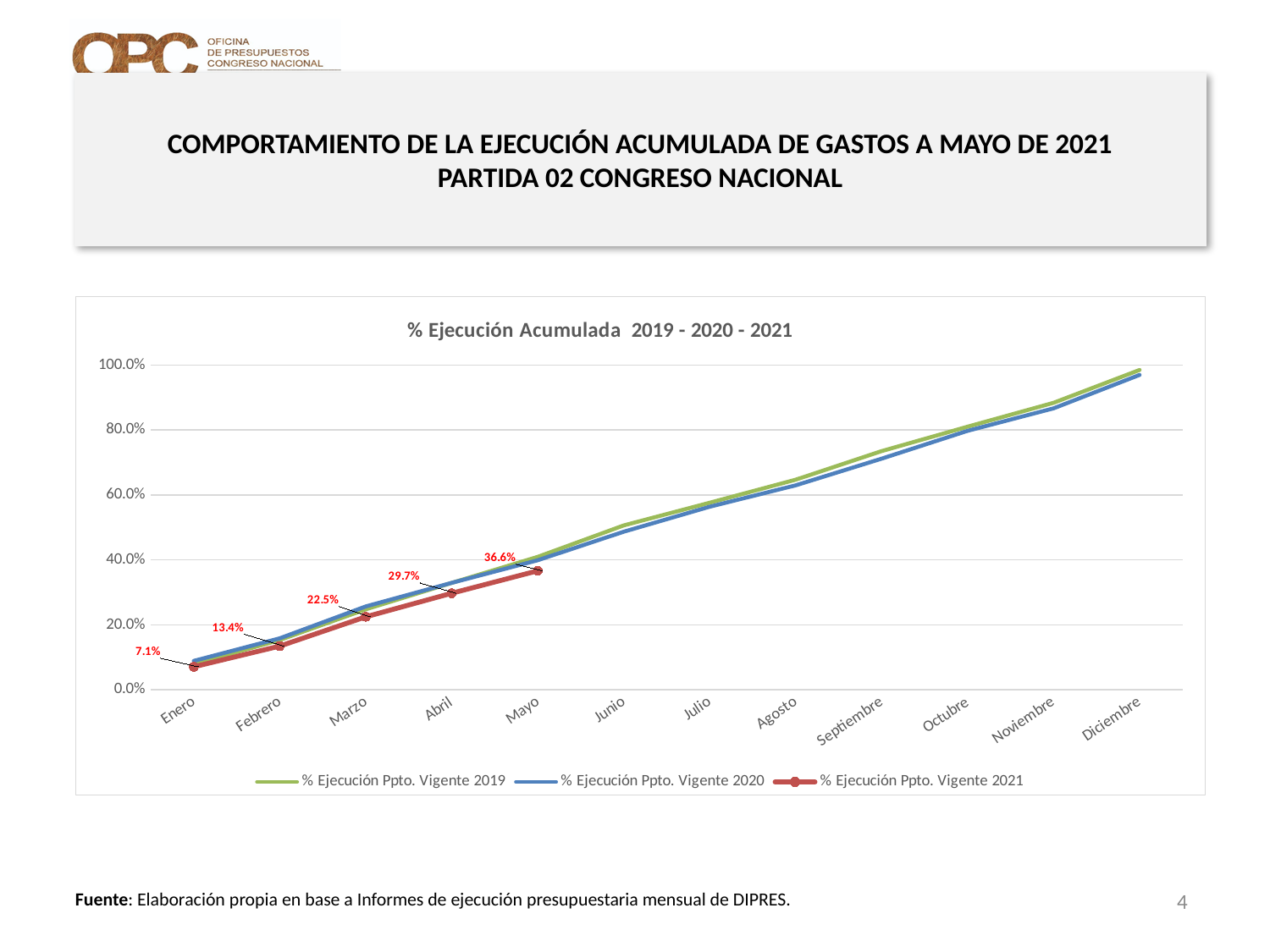
How many months are shown on the x axis? 12 What is the value of % Ejecución Ppto. Vigente 2021 for Enero? 7.1% What kind of chart is shown? Line chart What is the value of % Ejecución Ppto. Vigente 2021 for Mayo? 36.6% In which month does the % Ejecución Ppto. Vigente 2021 series have its lowest value? Enero What is the value of % Ejecución Ppto. Vigente 2021 for Marzo? 22.5% By how many percentage points does the 2021 series increase from Abril to Mayo? 6.9 How many series does the legend list? 3 By how many percentage points does the 2021 series increase from Febrero to Marzo? 9.1 What is the value of % Ejecución Ppto. Vigente 2021 for Abril? 29.7% Is the value for % Ejecución Ppto. Vigente 2020 in Diciembre greater or less than 80.0%? greater In which month does the % Ejecución Ppto. Vigente 2021 series reach its highest value? Mayo